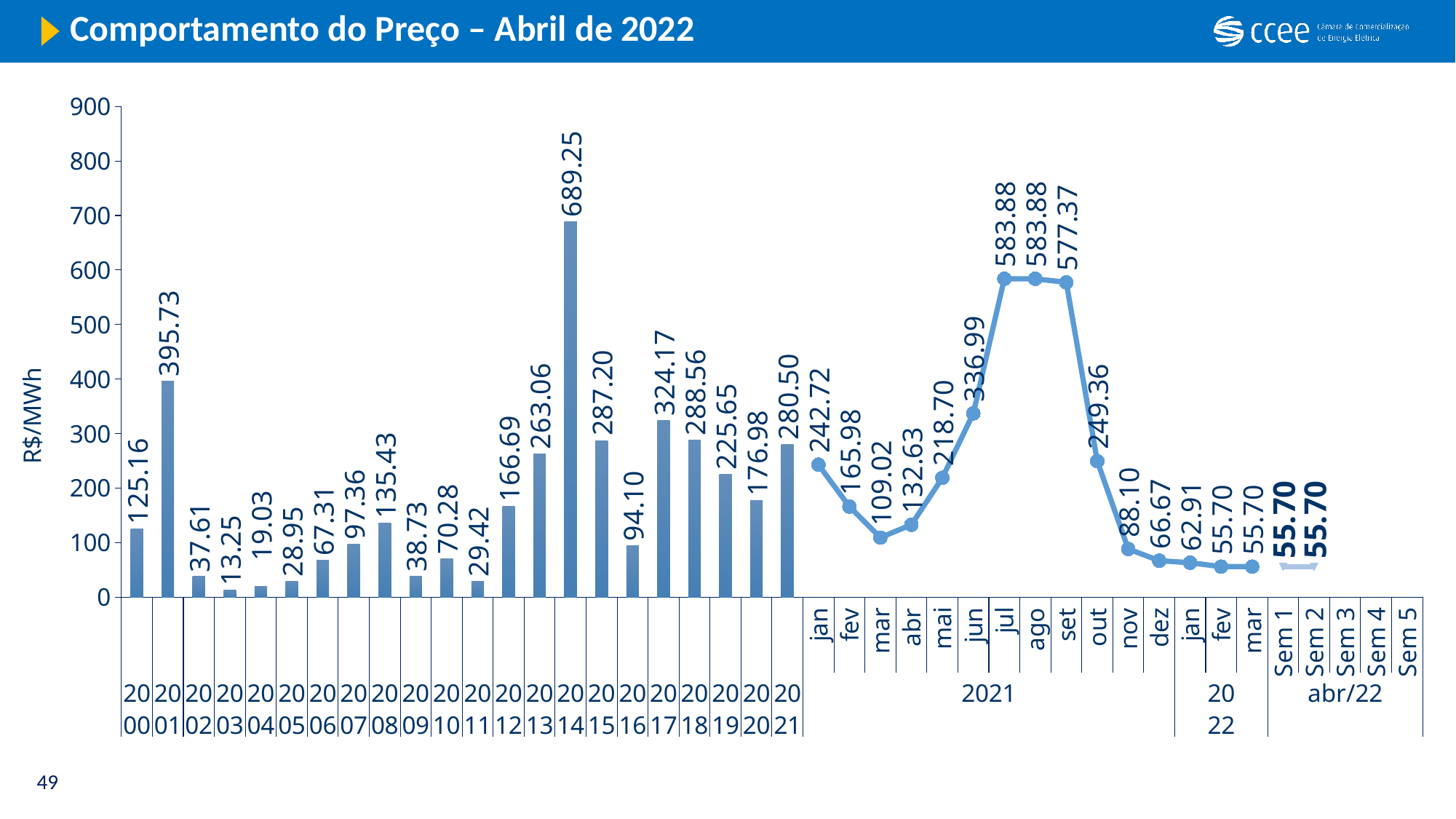
What is the value plotted for jul 2021 on the line? 583.88 What is the label on the vertical axis? R$/MWh Which year has the highest bar in the chart? 2014 What is the value of the bar for 2014? 689.25 What is the difference between the bar values for 2021 and 2020? 103.52 How many annual bars (years) are plotted in the chart? 22 What kind of chart is shown on the slide? Combined bar and line chart Which month of 2021 has the lowest value on the line? dez Which bar is larger, 2017 or 2018? 2017 Which year has the lowest bar in the chart? 2003 What is the value shown for Sem 2 of abr/22? 55.70 Do the monthly values rise or fall from jul 2021 to dez 2021? Fall